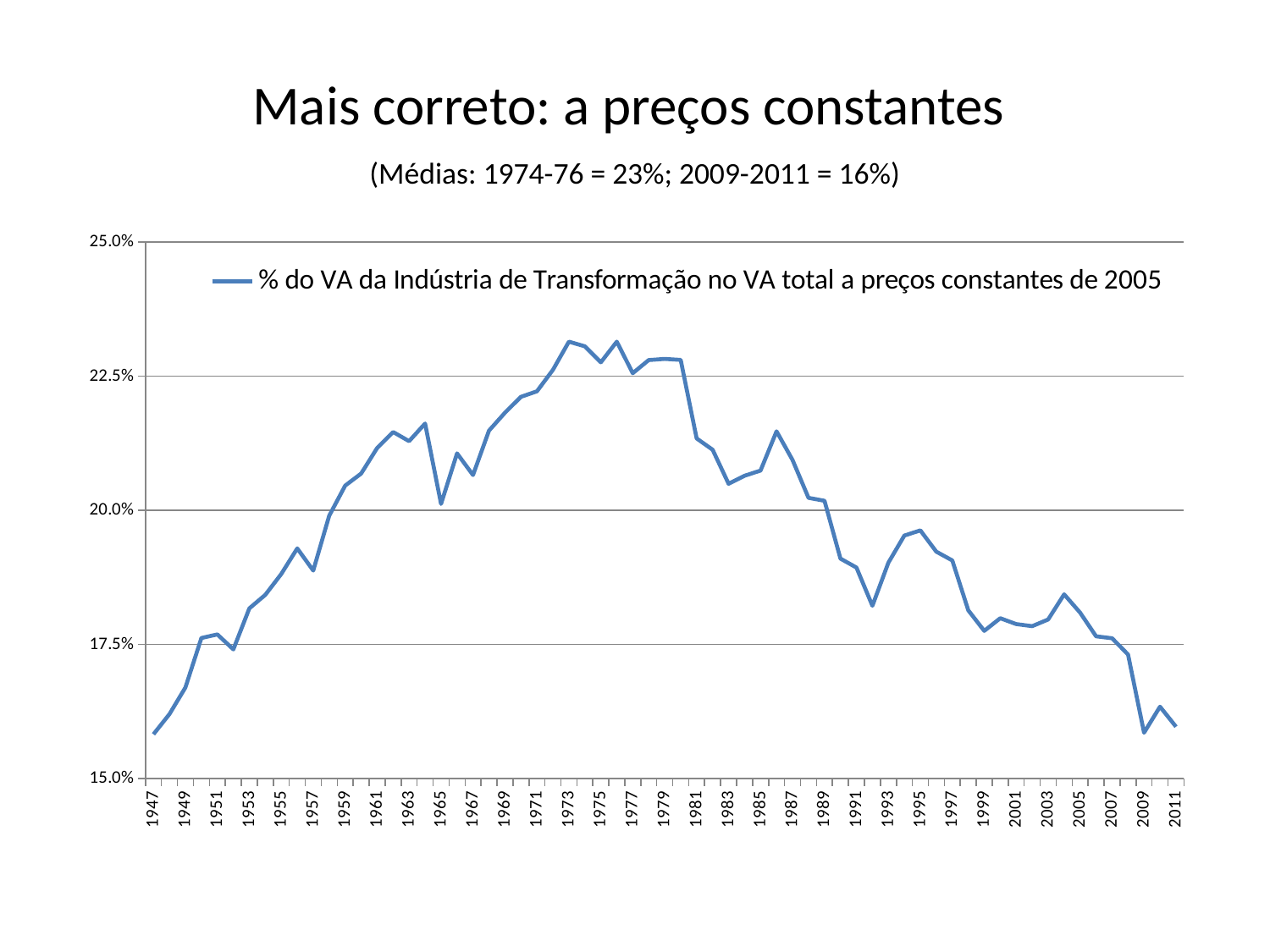
Is the value for 2009 greater or less than 17.5%? less Is the value for 1999 greater or less than 20.0%? less Do the values generally rise or fall between 1947 and 1973? rise Do the values generally rise or fall between 1980 and 2011? fall What is the legend entry for the plotted series? % do VA da Indústria de Transformação no VA total a preços constantes de 2005 Which year has the larger value, 1965 or 1973? 1973 Is the value for 1947 greater or less than 17.5%? less What is the title of the slide above the chart? Mais correto: a preços constantes What kind of chart is shown on the slide? line chart How many series does the legend list? 1